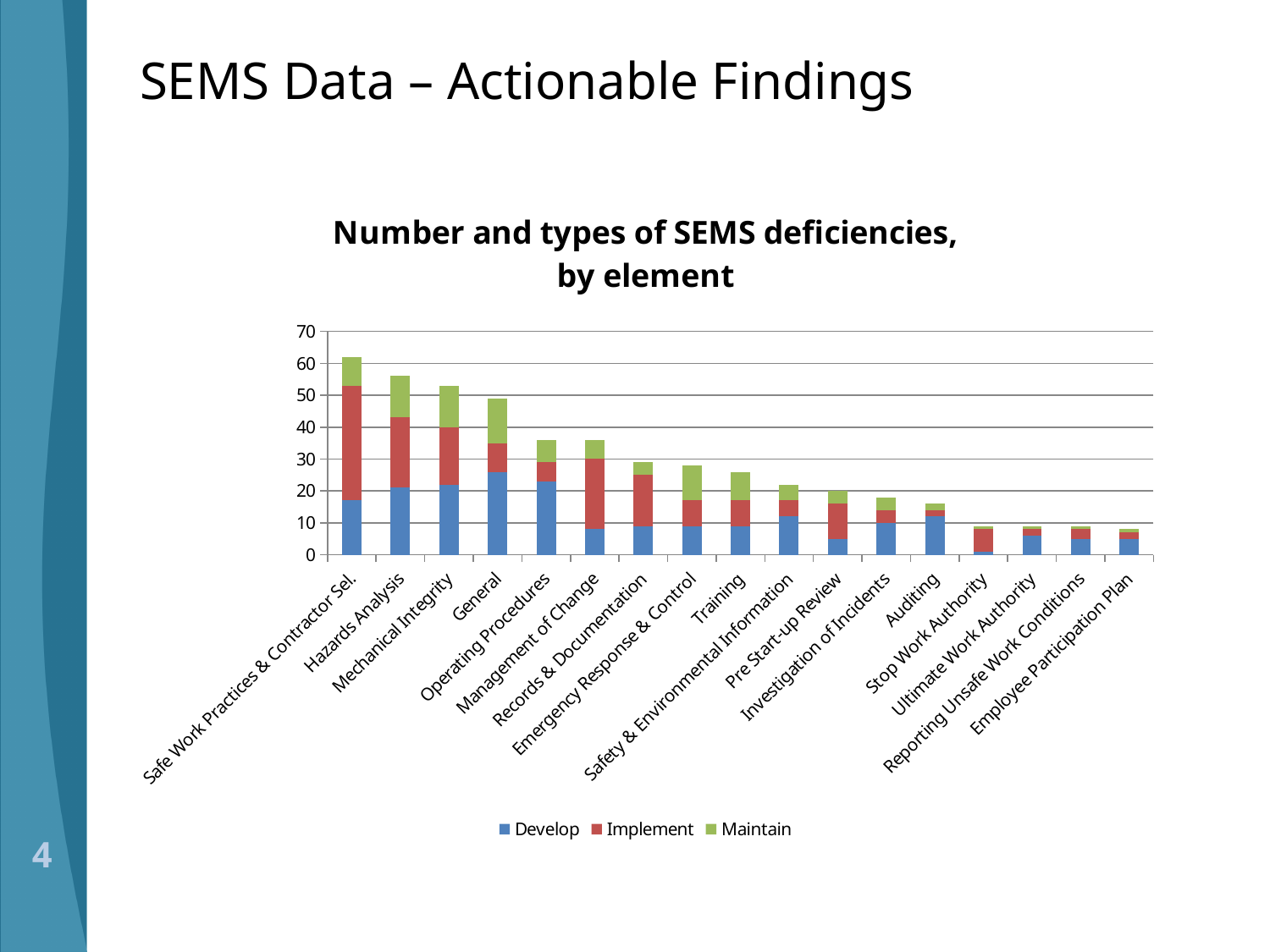
Is the Develop value for General greater or less than 20? greater How many categories (elements) are plotted along the x axis? 17 What kind of chart is shown on the slide? stacked bar chart Is the total value for Operating Procedures greater or less than 30? greater What is the title of the chart? Number and types of SEMS deficiencies, by element How many series does the legend list? 3 Do the total values rise or fall moving from left to right along the x axis? fall Which has a larger total, Hazards Analysis or General? Hazards Analysis Is the total value for Training greater or less than 20? greater Which element has the highest total number of deficiencies? Safe Work Practices & Contractor Sel.